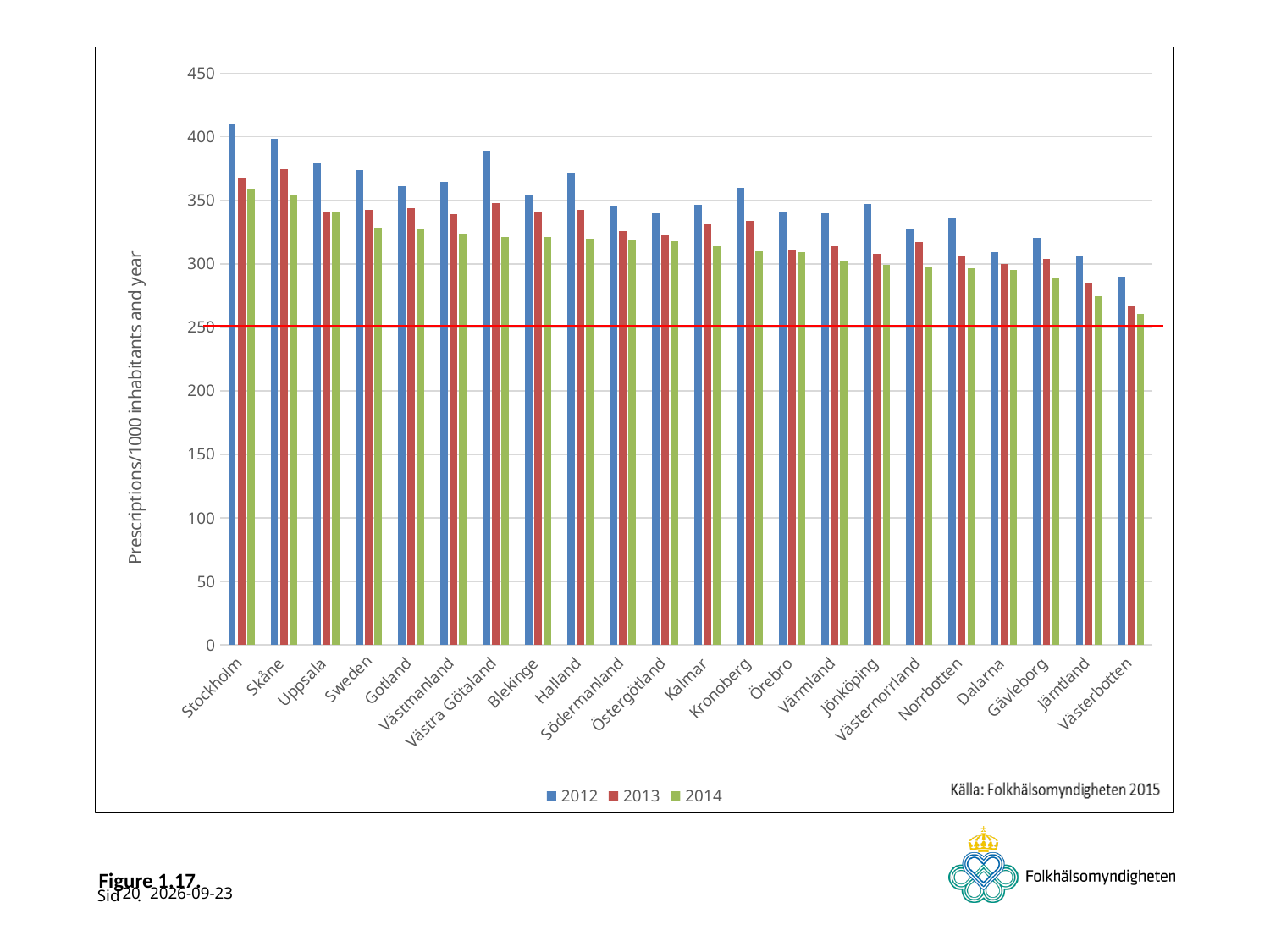
At what value on the y axis is the red horizontal line drawn? 250 What kind of chart is shown on the slide? bar chart Is the value for Västra Götaland in 2012 greater or less than 350? greater Which region has the lowest value for 2014? Västerbotten Which region has the highest value for 2012? Stockholm Which is larger, the 2012 value for Västra Götaland or the 2012 value for Blekinge? Västra Götaland Is the value for Västerbotten in 2012 greater or less than 300? less Is the value for Stockholm in 2012 greater or less than 350? greater Do the 2014 values generally rise or fall moving from left to right along the x axis? fall How many series does the legend list? 3 How many regions (categories) are shown on the x axis? 22